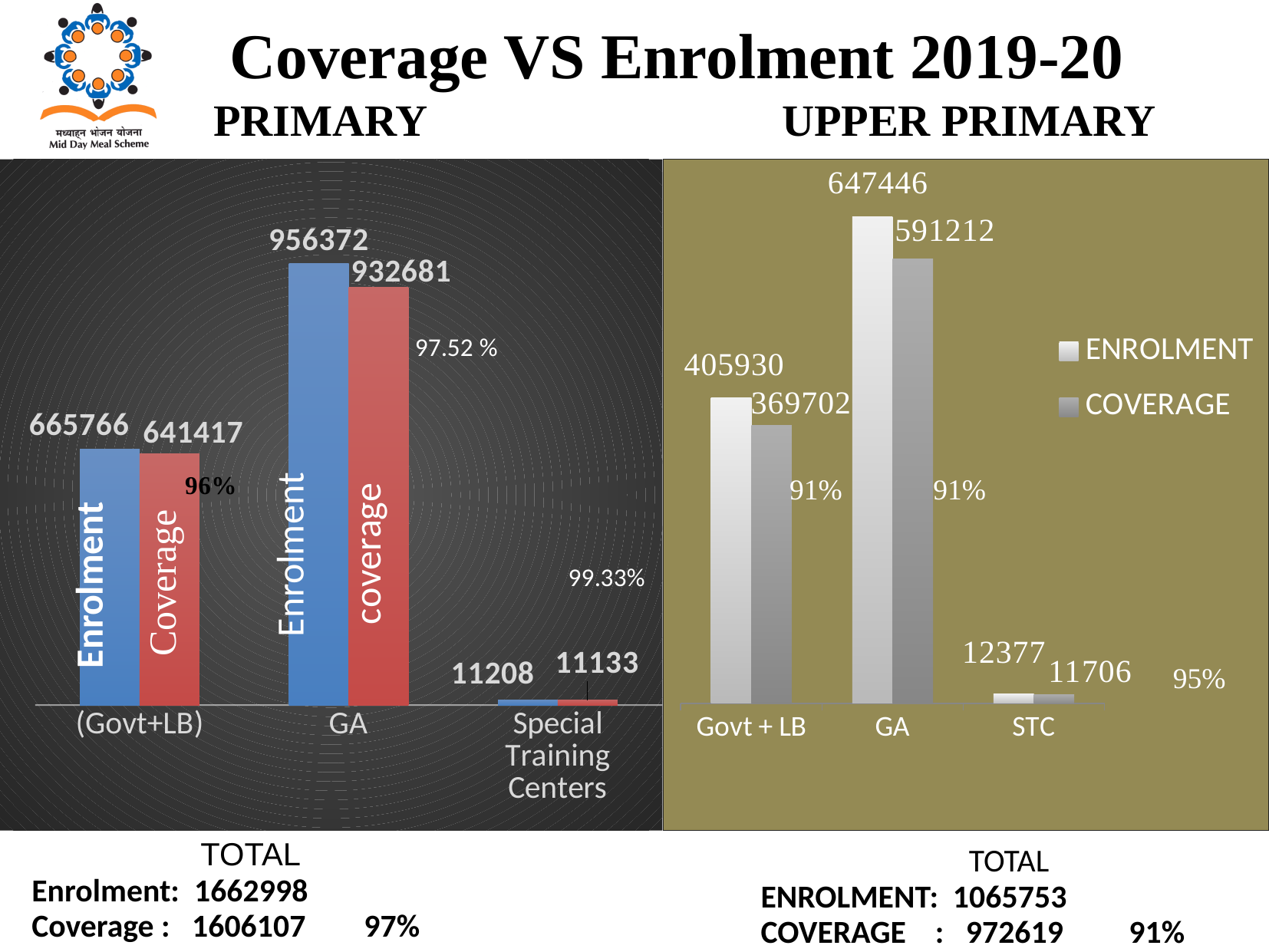
In the UPPER PRIMARY chart, what is the ENROLMENT value for Govt + LB? 405930 In the PRIMARY chart, what is the difference between Enrolment and Coverage for GA? 23691 In the UPPER PRIMARY chart, is the ENROLMENT for GA larger or smaller than the ENROLMENT for Govt + LB? larger In the UPPER PRIMARY chart, what is the COVERAGE value for GA? 591212 In the UPPER PRIMARY chart, which category has the lowest ENROLMENT? STC In the PRIMARY chart, what is the Enrolment value for GA? 956372 In the PRIMARY chart, what is the Coverage value for Special Training Centers? 11133 How many series does the legend of the UPPER PRIMARY chart list? 2 How many categories are shown on the x axis of the UPPER PRIMARY chart? 3 In the PRIMARY chart, what is the Coverage value for (Govt+LB)? 641417 In the PRIMARY chart, which category has the highest Enrolment? GA In the UPPER PRIMARY chart, what is the difference between ENROLMENT and COVERAGE for Govt + LB? 36228